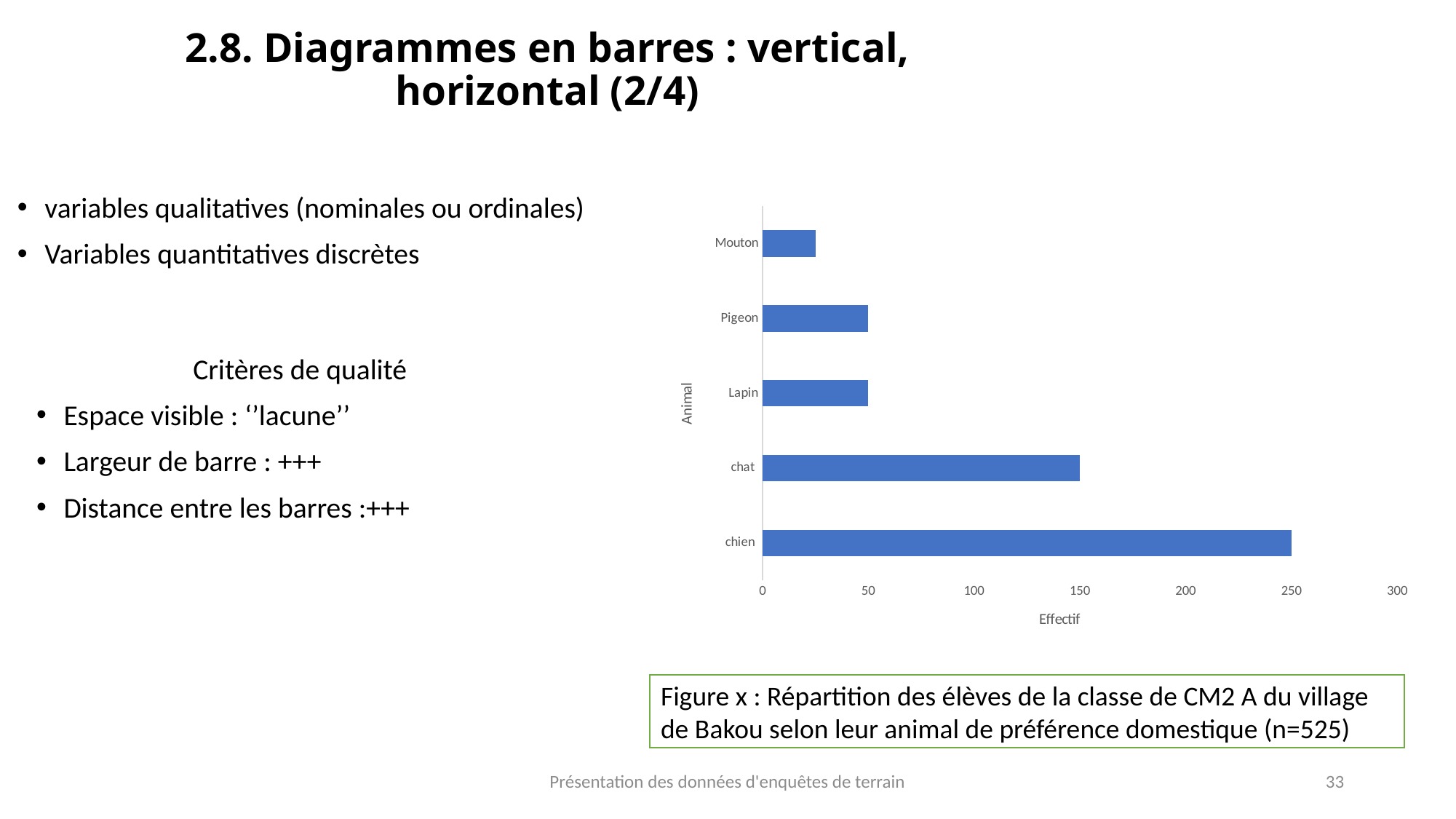
What is the Effectif value for chat? 150 What kind of chart is shown on the slide? bar chart What is the difference between the values for chien and chat? 100 What is the Effectif value for chien? 250 What is the label of the horizontal axis of the chart? Effectif Which animal has the lowest value (Effectif) in the chart? Mouton Which animal has the highest value (Effectif) in the chart? chien What is the label of the vertical axis of the chart? Animal Is the value for Mouton greater or less than 50? less What is the Effectif value for Pigeon? 50 Which has a larger value, chat or Pigeon? chat How many animal categories are plotted in the chart? 5